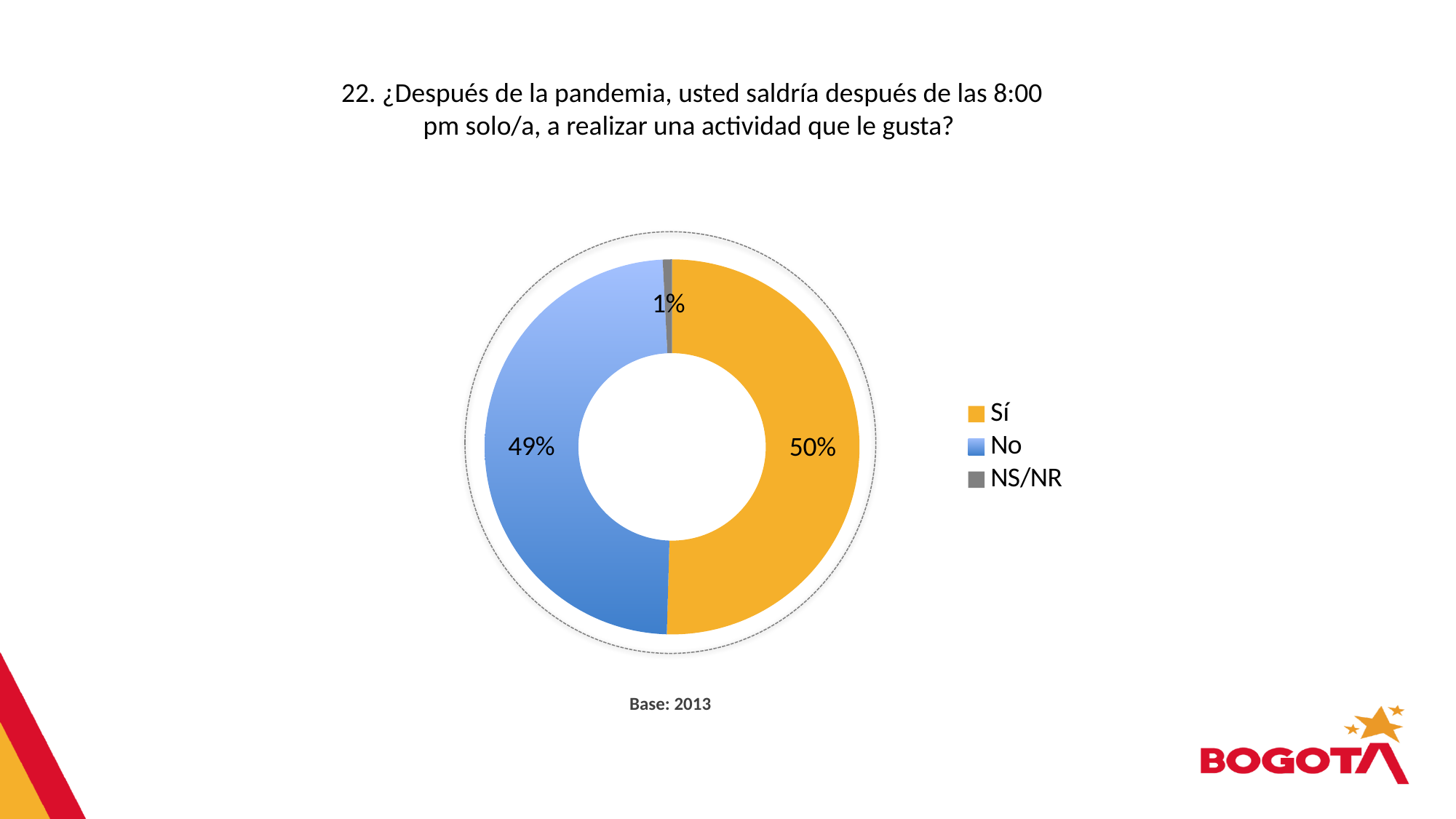
What percentage of respondents answered "Sí"? 50% Which response category has the largest share of the chart? Sí What is the difference in percentage points between the "Sí" and "No" shares? 1% What percentage of respondents answered "No"? 49% What colour represents the "Sí" category in the chart? Orange Which response category has the smallest share of the chart? NS/NR Which is larger, the share for "No" or the share for "NS/NR"? No What kind of chart is shown on the slide? doughnut chart How many response categories are shown in the chart? 3 What is the base (number of respondents) stated below the chart? 2013 What is the difference in percentage points between the "No" and "NS/NR" shares? 48% What percentage of respondents answered "NS/NR"? 1%